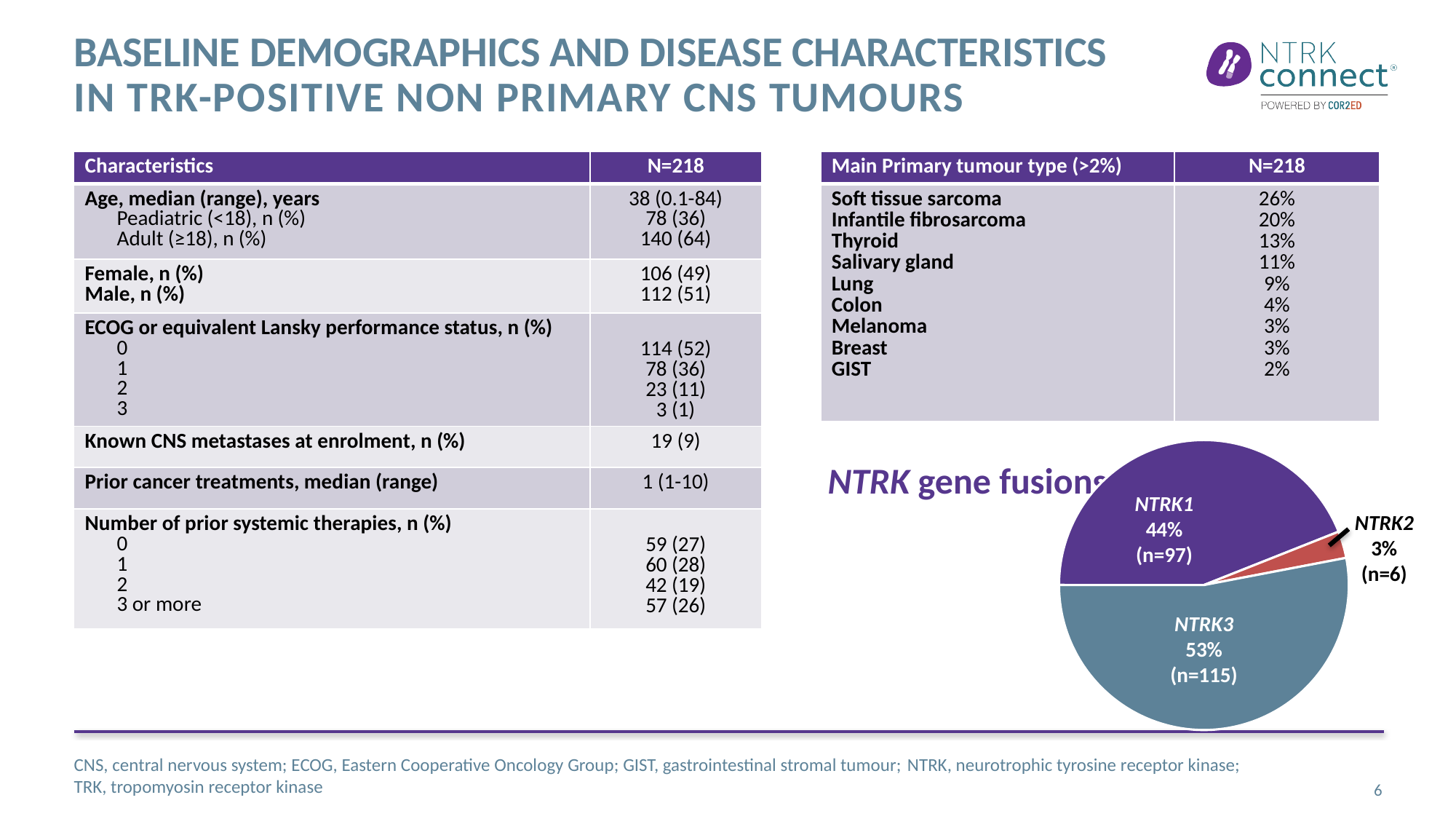
How many patients (n) are in the NTRK1 slice of the pie chart? n=97 Which slice is larger in the pie chart, NTRK1 or NTRK2? NTRK1 What is the difference in percentage points between the NTRK3 and NTRK1 slices? 9 What share of the pie chart does NTRK3 represent? 53% Which gene fusion has the smallest slice in the pie chart? NTRK2 How many patients (n) are in the NTRK3 slice of the pie chart? n=115 Which gene fusion has the largest slice in the pie chart? NTRK3 How many slices does the pie chart have? 3 How many patients (n) are in the NTRK2 slice of the pie chart? n=6 What share of the pie chart does NTRK1 represent? 44% What kind of chart is shown on the slide? pie chart What share of the pie chart does NTRK2 represent? 3%